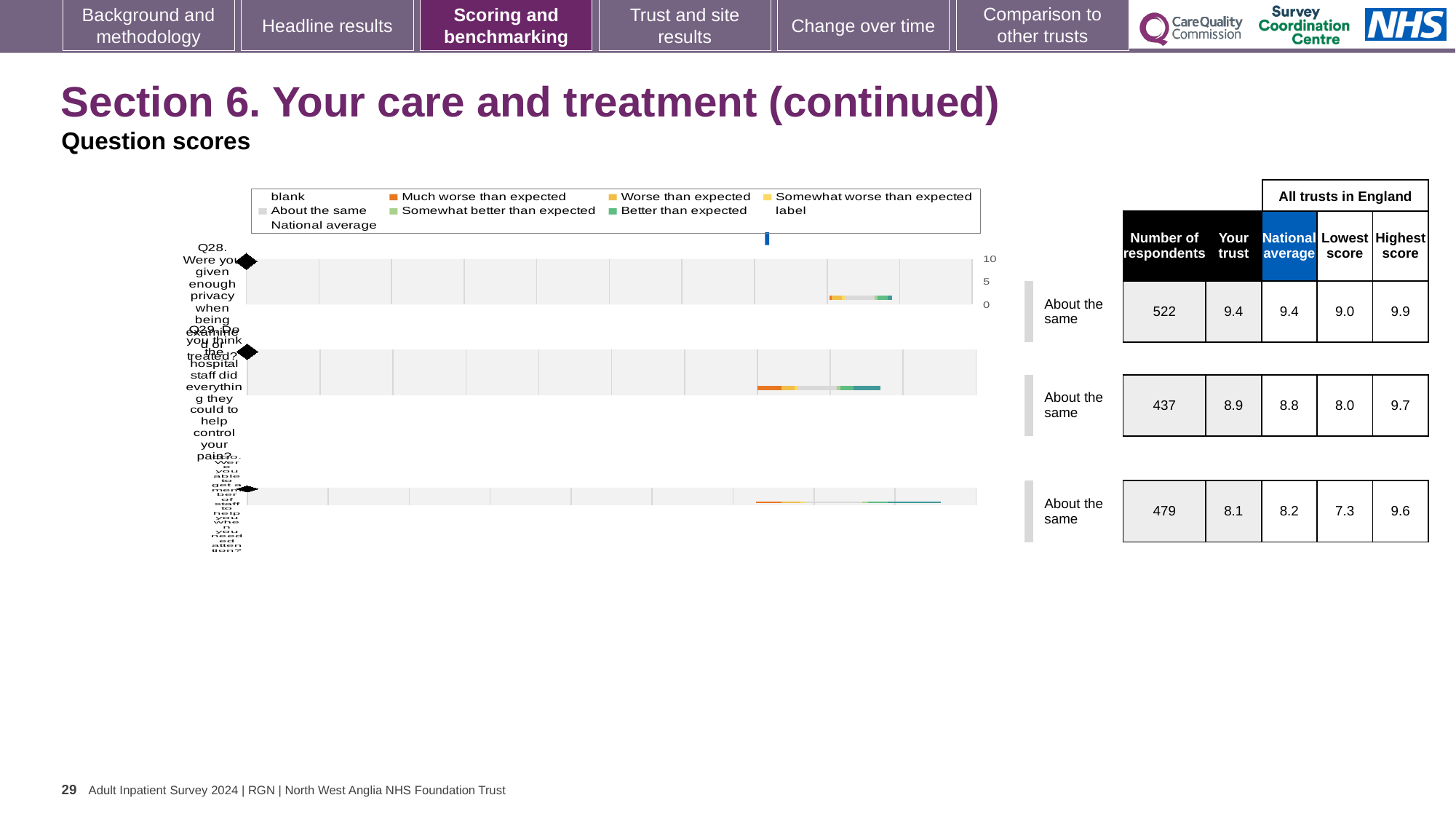
Which question has the lowest 'Lowest score' among all trusts in England? Q30 What benchmark category is shown for Q28? About the same What is the highest score across all trusts in England for Q28? 9.9 How many questions are plotted on this slide? 3 Which question has the highest 'Your trust' score? Q28 What is the national average score for Q30 (Were you able to get a member of staff to help you when you needed attention?)? 8.2 What kind of chart is used to show the question scores? Bar chart What is the difference between the highest score and the lowest score for Q29? 1.7 What is the 'Your trust' score for Q28 (Were you given enough privacy when being examined or treated?)? 9.4 For Q30, which is larger: the 'Your trust' score or the national average? National average How many respondents answered Q29 (Do you think the hospital staff did everything they could to help control your pain?)? 437 What is the maximum value shown on the chart's score axis? 10